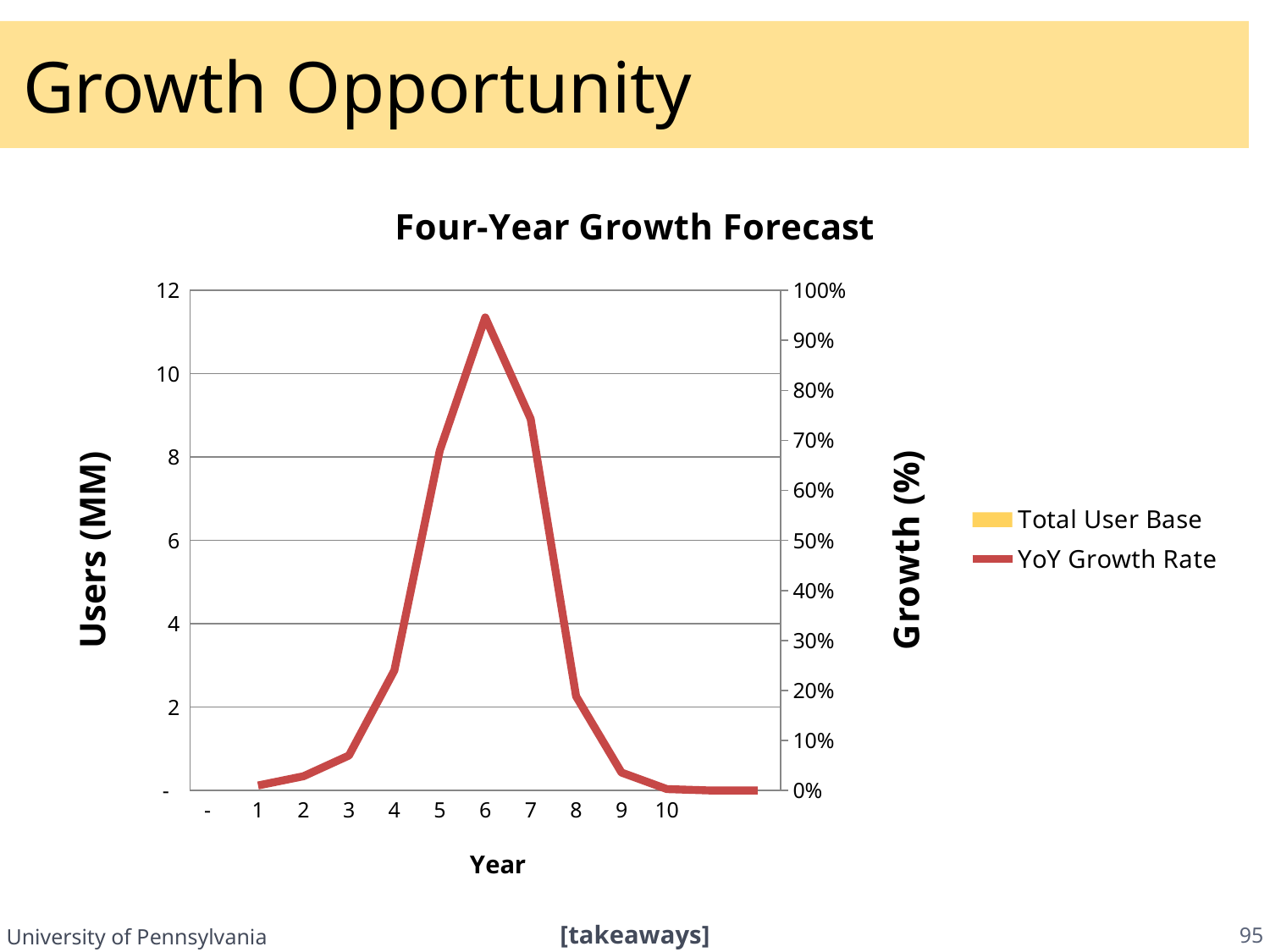
Which year has the higher YoY Growth Rate, year 4 or year 6? 6 How many series does the legend list? 2 Is the YoY Growth Rate in year 4 greater or less than 20%? greater What is the title of the chart? Four-Year Growth Forecast Does the YoY Growth Rate rise or fall from year 1 to year 6? rise What kind of chart is used to plot the YoY Growth Rate? line chart What is the label of the right-hand vertical axis? Growth (%) In which year does the YoY Growth Rate reach its highest value? 6 Is the YoY Growth Rate in year 6 greater or less than 90%? greater Is the YoY Growth Rate in year 7 greater or less than 70%? greater Does the YoY Growth Rate rise or fall from year 6 to year 10? fall